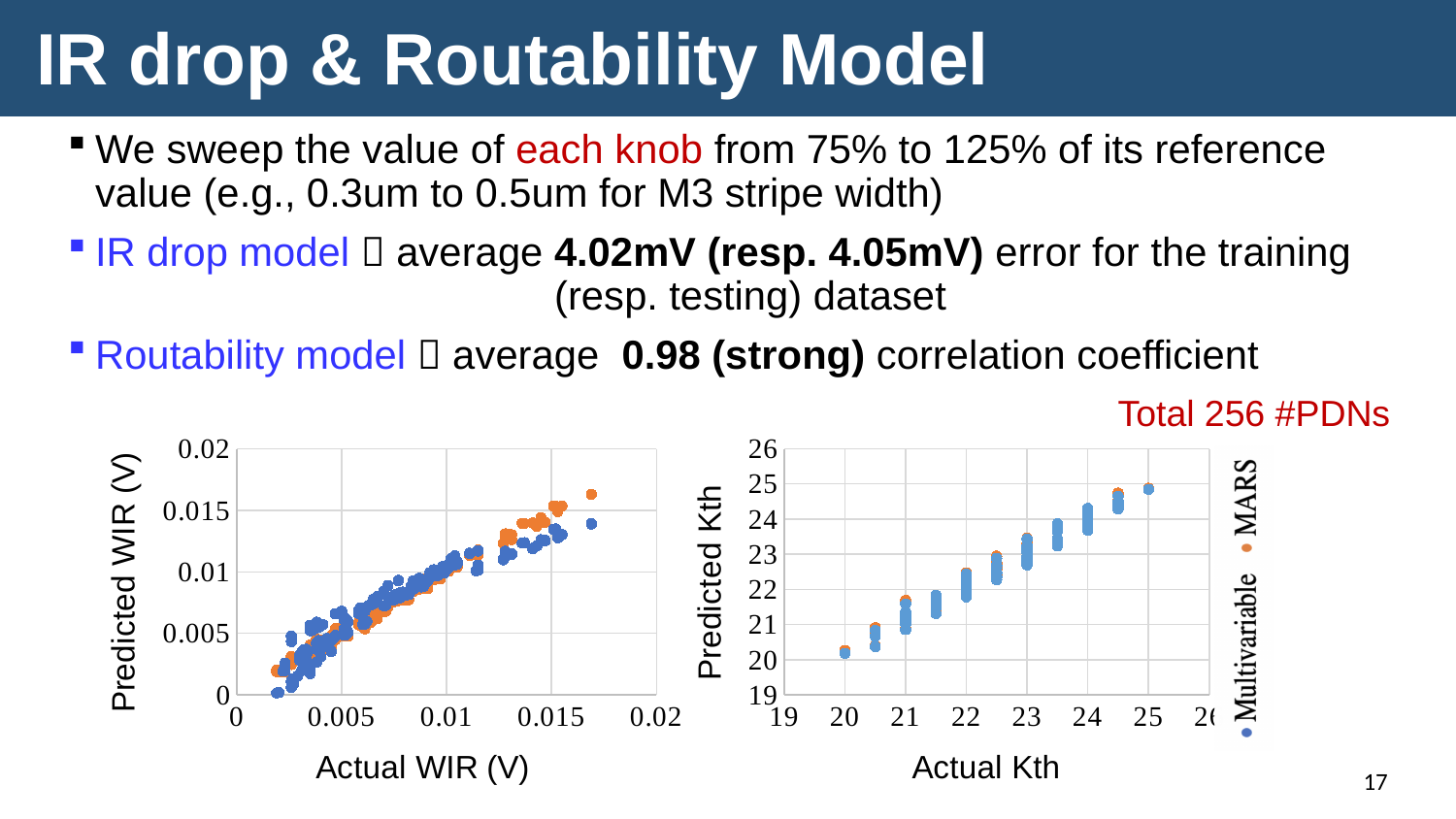
In the right chart (Predicted Kth vs Actual Kth), which series is shown in orange? MARS What kind of chart is the left chart (Predicted WIR vs Actual WIR)? scatter chart What kind of chart is the right chart (Predicted Kth vs Actual Kth)? scatter chart In the right chart, are the predicted Kth values at an actual Kth of 20 greater or less than 21? less In the right chart, are the predicted Kth values at an actual Kth of 25 greater or less than 24? greater In the right chart, do the predicted Kth values rise or fall as the actual Kth increases along the x axis? rise In the left chart, are the predicted WIR values at an actual WIR of 0.015 greater or less than 0.01? greater In the right chart (Predicted Kth vs Actual Kth), which series is shown in blue? Multivariable In the left chart, do the predicted WIR values rise or fall as the actual WIR increases along the x axis? rise In the right chart (Predicted Kth vs Actual Kth), how many series does the legend list? 2